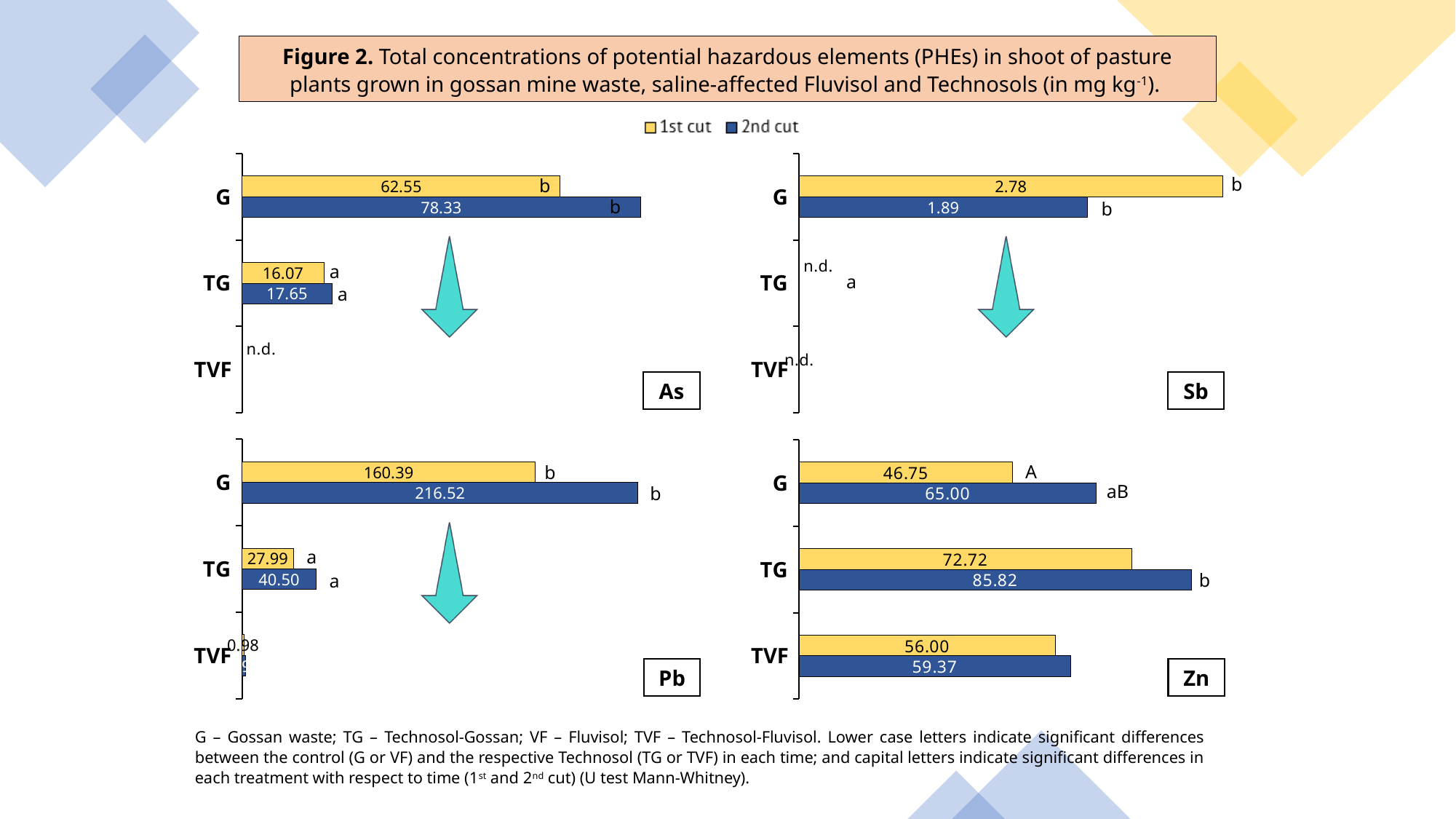
In the Zn chart, what is the 1st cut value for TVF? 56.00 In the As chart, what is the 2nd cut value for TG? 17.65 In the Pb chart, what is the difference between the 2nd cut and 1st cut values for G? 56.13 In the Zn chart, which category has the highest 2nd cut value? TG In the Zn chart, which category has the lowest 1st cut value? G In the As chart, what is the 1st cut value for G? 62.55 In the Sb chart, what is shown for the TVF category? n.d. In the Pb chart, what is the 2nd cut value for G? 216.52 In the As chart, which is larger for G: the 1st cut value or the 2nd cut value? 2nd cut What kind of chart is the Zn chart? Bar chart In the Sb chart, what is the 2nd cut value for G? 1.89 How many series does the legend list? 2